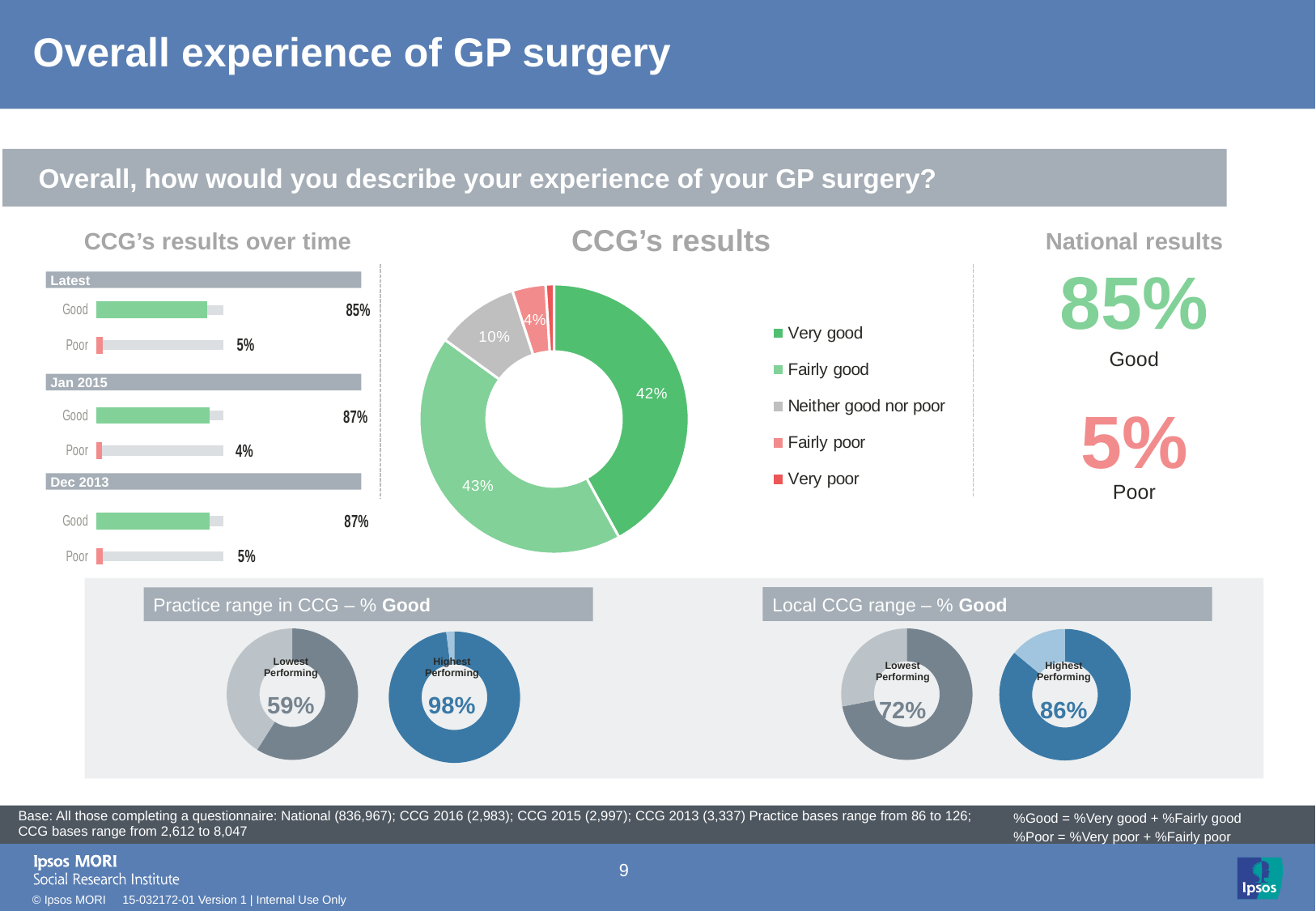
In the 'CCG's results over time' chart, did the Good percentage rise or fall from Jan 2015 to Latest? fall How many categories does the legend of the 'CCG's results' donut chart list? 5 In the 'Local CCG range – % Good' section, what is the difference between the Highest Performing and Lowest Performing values? 14 percentage points In the 'CCG's results' donut chart, which category has the smallest slice? Very poor In the 'CCG's results over time' chart, how many time periods are shown? 3 In the 'CCG's results over time' chart, what is the Good percentage for Latest? 85% In the 'CCG's results' donut chart, what percentage is Neither good nor poor? 10% In the 'Practice range in CCG – % Good' section, what is the Lowest Performing value? 59% In the 'CCG's results over time' chart, what is the difference between the Good and Poor percentages for Latest? 80 percentage points In the 'CCG's results over time' chart, is the Poor value for Latest larger or smaller than the Poor value for Jan 2015? larger In the 'CCG's results over time' chart, what is the Poor percentage for Jan 2015? 4% In the 'CCG's results' donut chart, what percentage is Fairly good? 43%